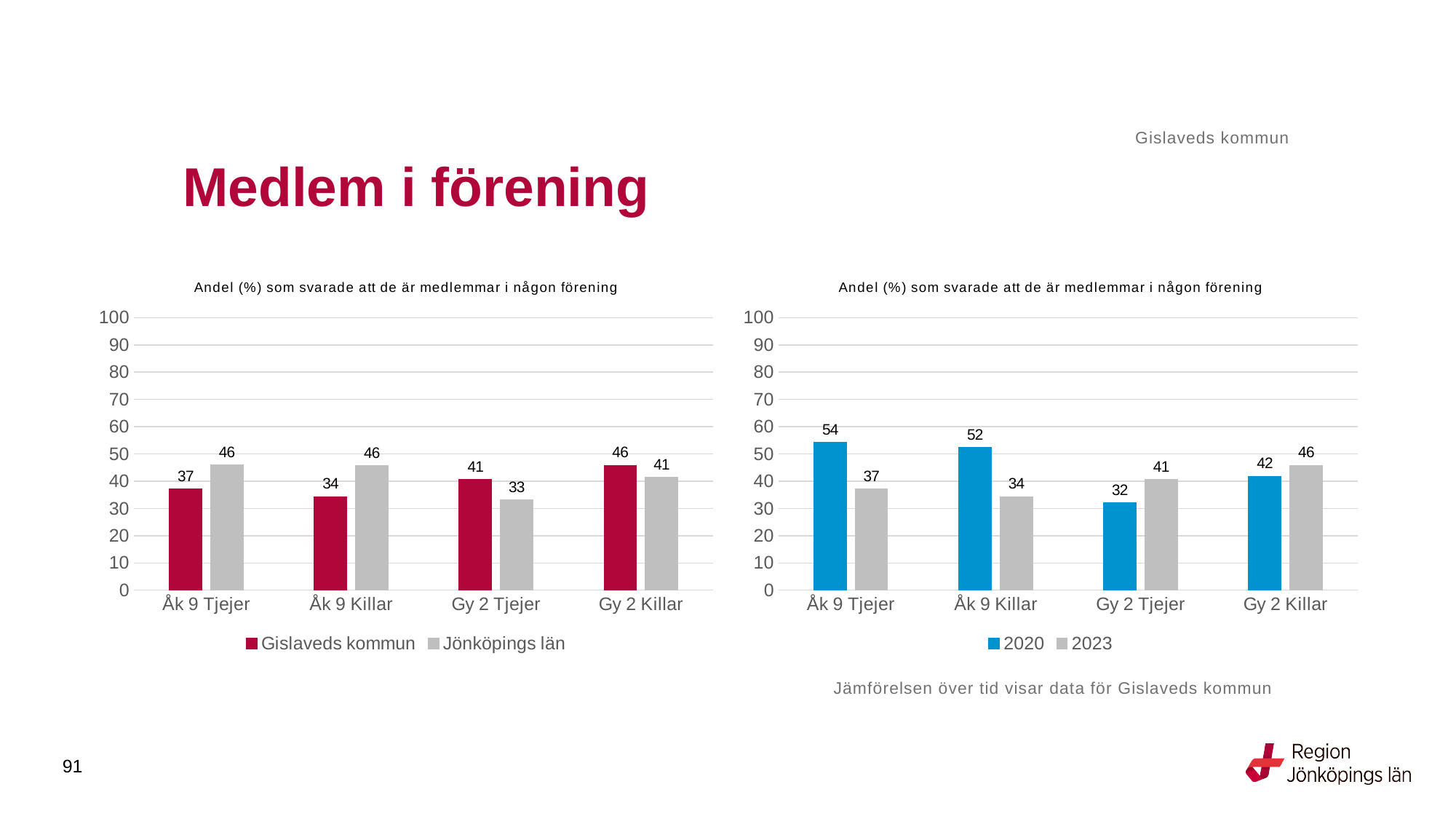
In the left chart, what is the value for Gislaveds kommun for Åk 9 Tjejer? 37 In the right chart, which category has the highest value for 2020? Åk 9 Tjejer In the right chart, which is larger for Gy 2 Tjejer: 2020 or 2023? 2023 What kind of chart is the left chart? Bar chart In the right chart, what is the value for 2023 for Gy 2 Killar? 46 In the left chart, what is the value for Jönköpings län for Gy 2 Tjejer? 33 In the right chart, what is the value for 2020 for Åk 9 Tjejer? 54 In the left chart, which is larger for Gy 2 Killar: Gislaveds kommun or Jönköpings län? Gislaveds kommun In the left chart, what is the difference between Jönköpings län and Gislaveds kommun for Åk 9 Killar? 12 In the left chart, which category has the lowest value for Gislaveds kommun? Åk 9 Killar In the right chart, what is the difference between 2020 and 2023 for Åk 9 Killar? 18 How many series does the legend of the right chart list? 2